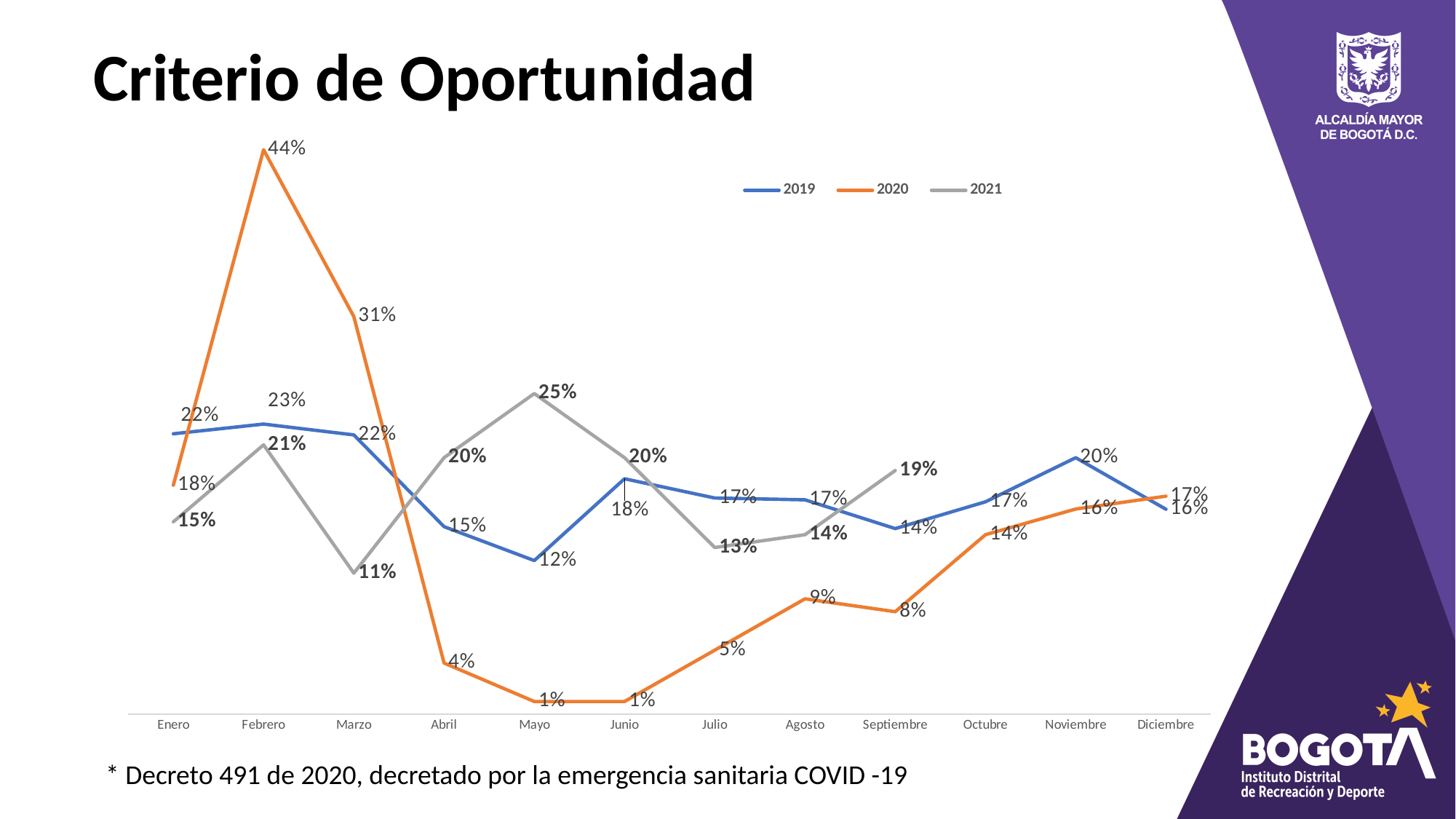
In which month does the 2019 series reach its lowest value? Mayo What type of chart is shown on the slide? line chart How many series does the legend list? 3 Does the 2020 series rise or fall from Junio to Diciembre? rise What is the value for 2020 in Febrero? 44% How many months are shown on the x axis? 12 What is the value for 2021 in Mayo? 25% What is the value for 2019 in Septiembre? 14% What is the title of the chart? Criterio de Oportunidad What is the difference between the 2020 value in Febrero and the 2020 value in Marzo? 13% Which series has the higher value in Abril, 2019 or 2021? 2021 In which month does the 2020 series reach its highest value? Febrero